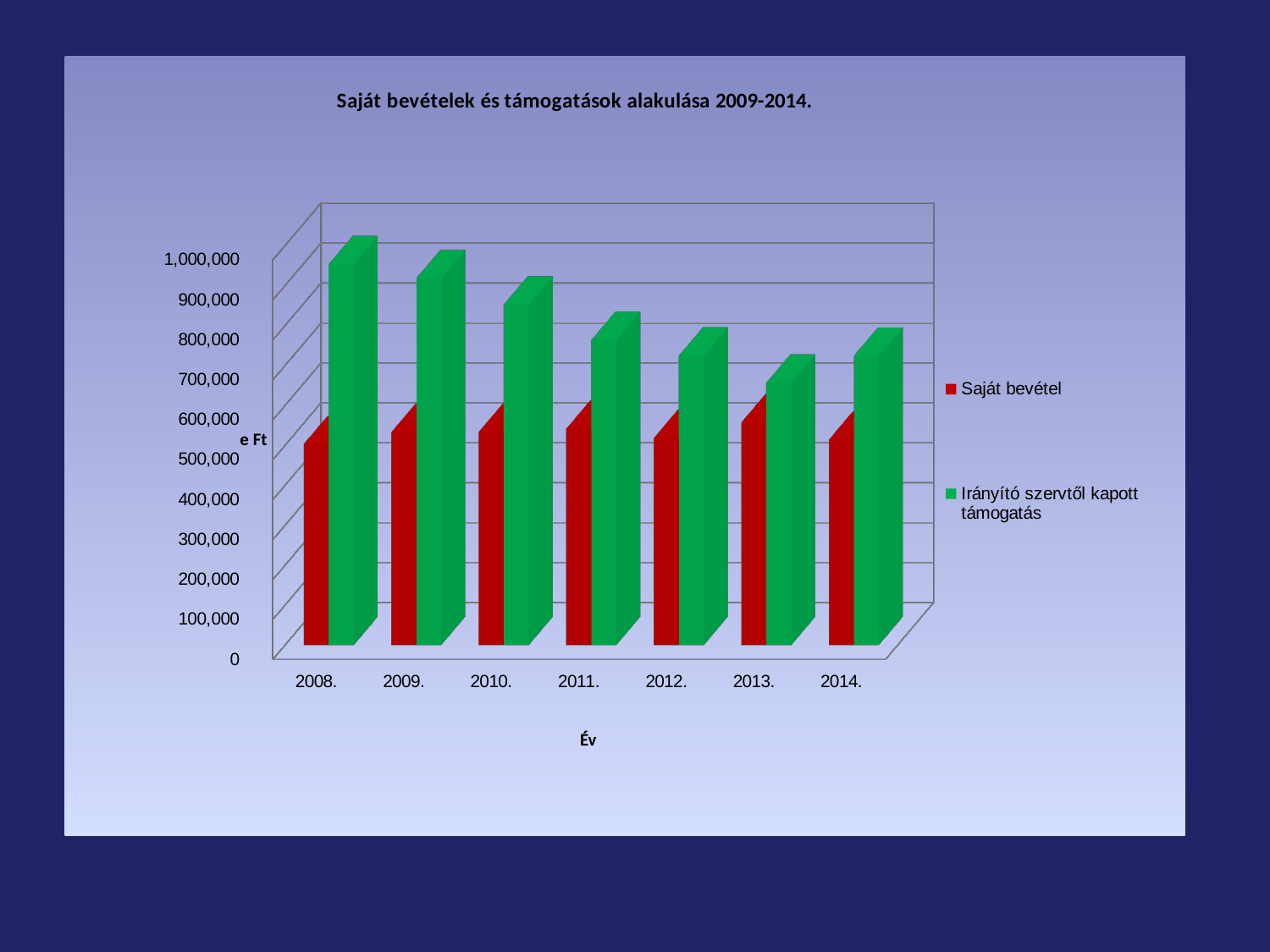
From 2008 to 2013, does the value for Irányító szervtől kapott támogatás rise or fall? fall What colour are the bars for Saját bevétel? red Which year has the highest value for Irányító szervtől kapott támogatás? 2008. Which year has the lowest value for Irányító szervtől kapott támogatás? 2013. In 2010, which is larger: Saját bevétel or Irányító szervtől kapott támogatás? Irányító szervtől kapott támogatás How many years are shown on the x axis? 7 Is the value for Irányító szervtől kapott támogatás in 2008 greater or less than 900,000? greater What kind of chart is shown on the slide? bar chart Is the value for Irányító szervtől kapott támogatás in 2013 greater or less than 800,000? less How many series does the legend list? 2 Is the value for Saját bevétel in 2012 greater or less than 700,000? less What is the title of the chart? Saját bevételek és támogatások alakulása 2009-2014.